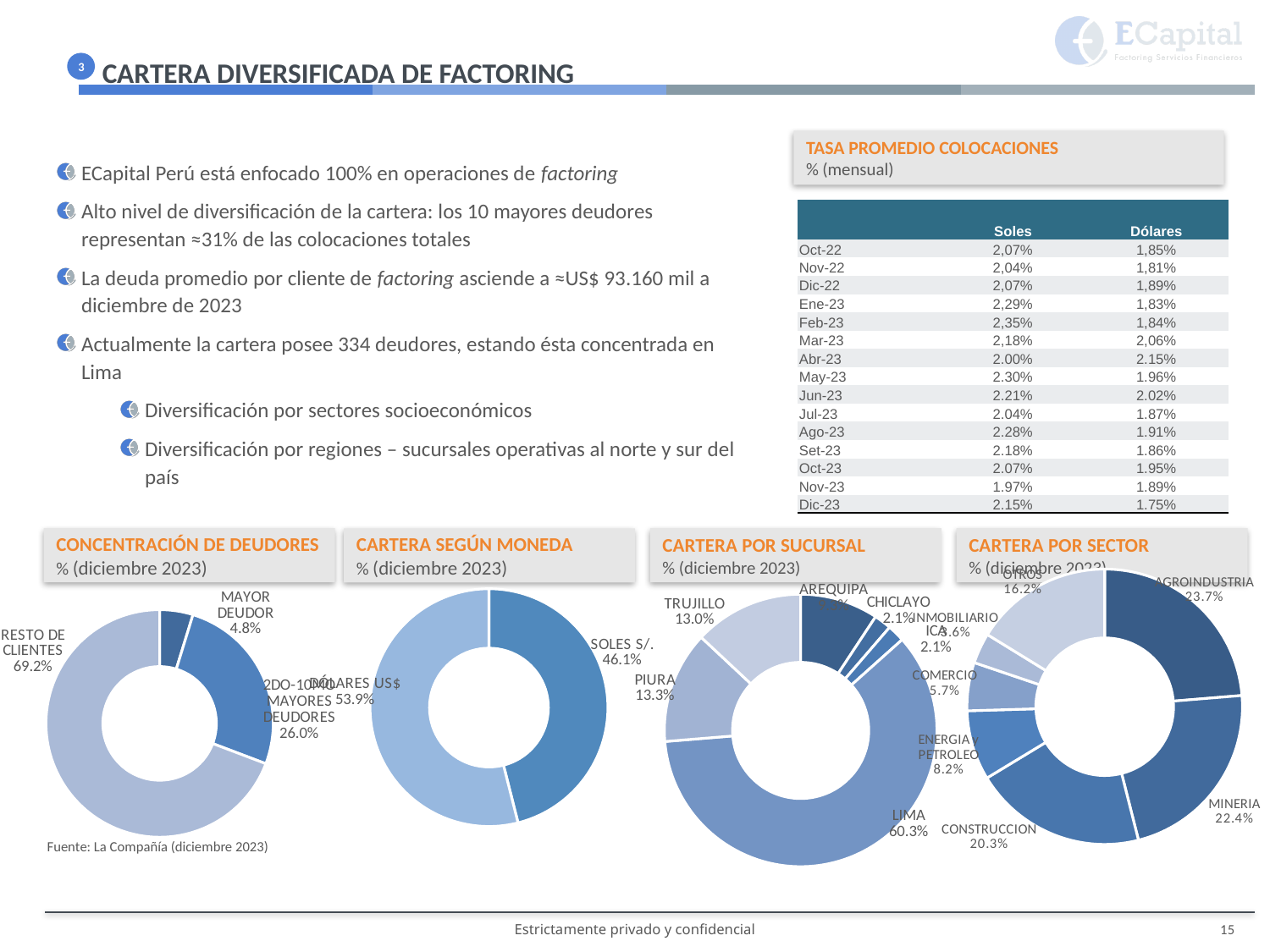
In the 'Cartera por Sucursal' chart, which branch has the largest share? Lima In the 'Cartera por Sector' chart, what is the difference between the Construcción share and the Comercio share? 14.6% What type of chart is used for 'Cartera por Sector'? Donut (pie) chart In the 'Concentración de Deudores' chart, what share does 'Mayor Deudor' represent? 4.8% In the 'Cartera según Moneda' chart, what is the difference between the Dólares share and the Soles share? 7.8% In the 'Cartera por Sector' chart, which sector has the largest share? Agroindustria In the 'Cartera por Sucursal' chart, what is the share for Lima? 60.3% In the 'Cartera según Moneda' chart, what is the share for 'Dólares US$'? 53.9% In the 'Cartera por Sector' chart, what is the share for Minería? 22.4% In the 'Cartera según Moneda' chart, which currency has the larger share, Soles or Dólares? Dólares US$ In the 'Concentración de Deudores' chart, what share is 'Resto de Clientes'? 69.2% In the 'Cartera por Sucursal' chart, what is the share for Piura? 13.3%